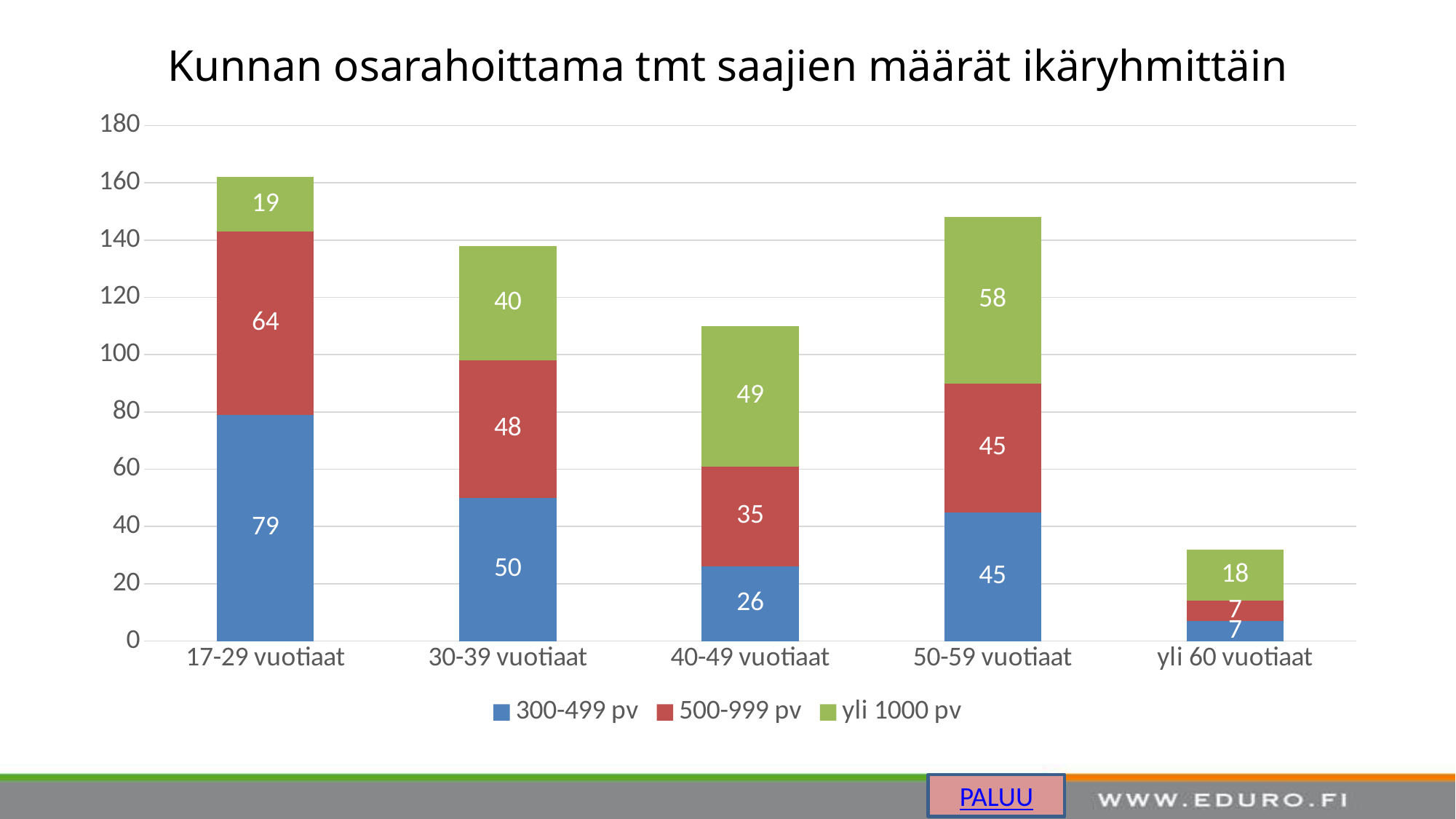
How many age groups are shown on the x axis? 5 Which age group has the lowest value in the yli 1000 pv series? yli 60 vuotiaat Which is larger: the yli 1000 pv value for 40-49 vuotiaat or for 30-39 vuotiaat? 40-49 vuotiaat How many series does the legend list? 3 What is the value of the yli 1000 pv series for 50-59 vuotiaat? 58 Which age group has the highest value in the 300-499 pv series? 17-29 vuotiaat What is the difference between the 500-999 pv values for 17-29 vuotiaat and 30-39 vuotiaat? 16 What type of chart is shown on the slide? stacked bar chart What is the total of the stacked bar for yli 60 vuotiaat? 32 What is the value of the 300-499 pv series for 17-29 vuotiaat? 79 What is the value of the 500-999 pv series for 40-49 vuotiaat? 35 What is the total of the stacked bar for 30-39 vuotiaat? 138